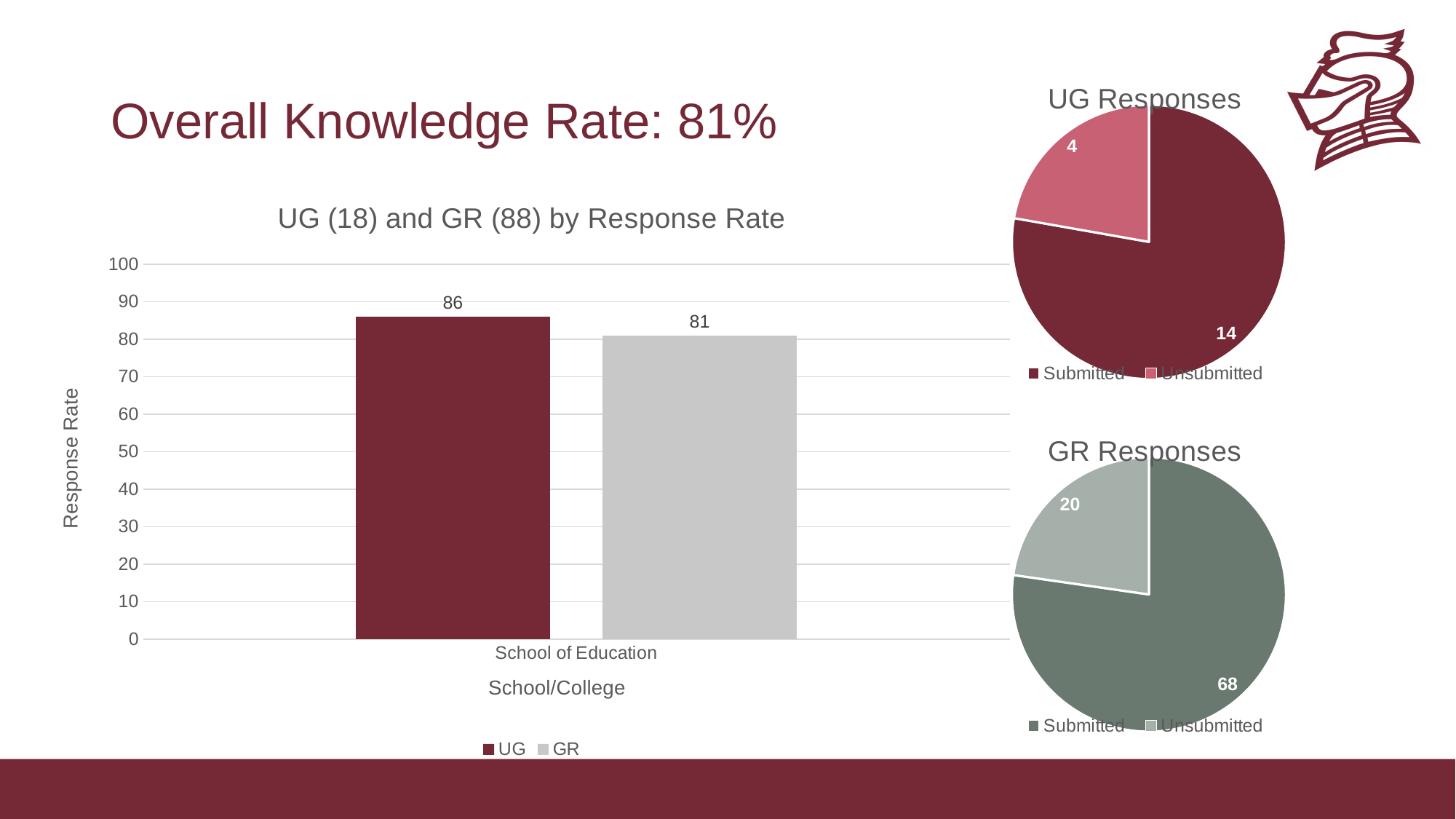
In the bar chart titled 'UG (18) and GR (88) by Response Rate', how many series does the legend list? 2 In the bar chart titled 'UG (18) and GR (88) by Response Rate', what is the response rate for UG? 86 In the bar chart titled 'UG (18) and GR (88) by Response Rate', what is the label on the y axis? Response Rate In the 'GR Responses' pie chart, how many responses were Unsubmitted? 20 In the 'UG Responses' pie chart, how many responses were Submitted? 14 In the 'GR Responses' pie chart, which slice is larger, Submitted or Unsubmitted? Submitted In the bar chart titled 'UG (18) and GR (88) by Response Rate', what is the difference between the UG and GR response rates? 5 In the bar chart titled 'UG (18) and GR (88) by Response Rate', what is the response rate for GR? 81 In the 'GR Responses' pie chart, how many responses were Submitted? 68 What kind of chart is the chart titled 'UG (18) and GR (88) by Response Rate'? Bar chart In the 'UG Responses' pie chart, how many responses were Unsubmitted? 4 In the bar chart titled 'UG (18) and GR (88) by Response Rate', which series has the higher response rate, UG or GR? UG